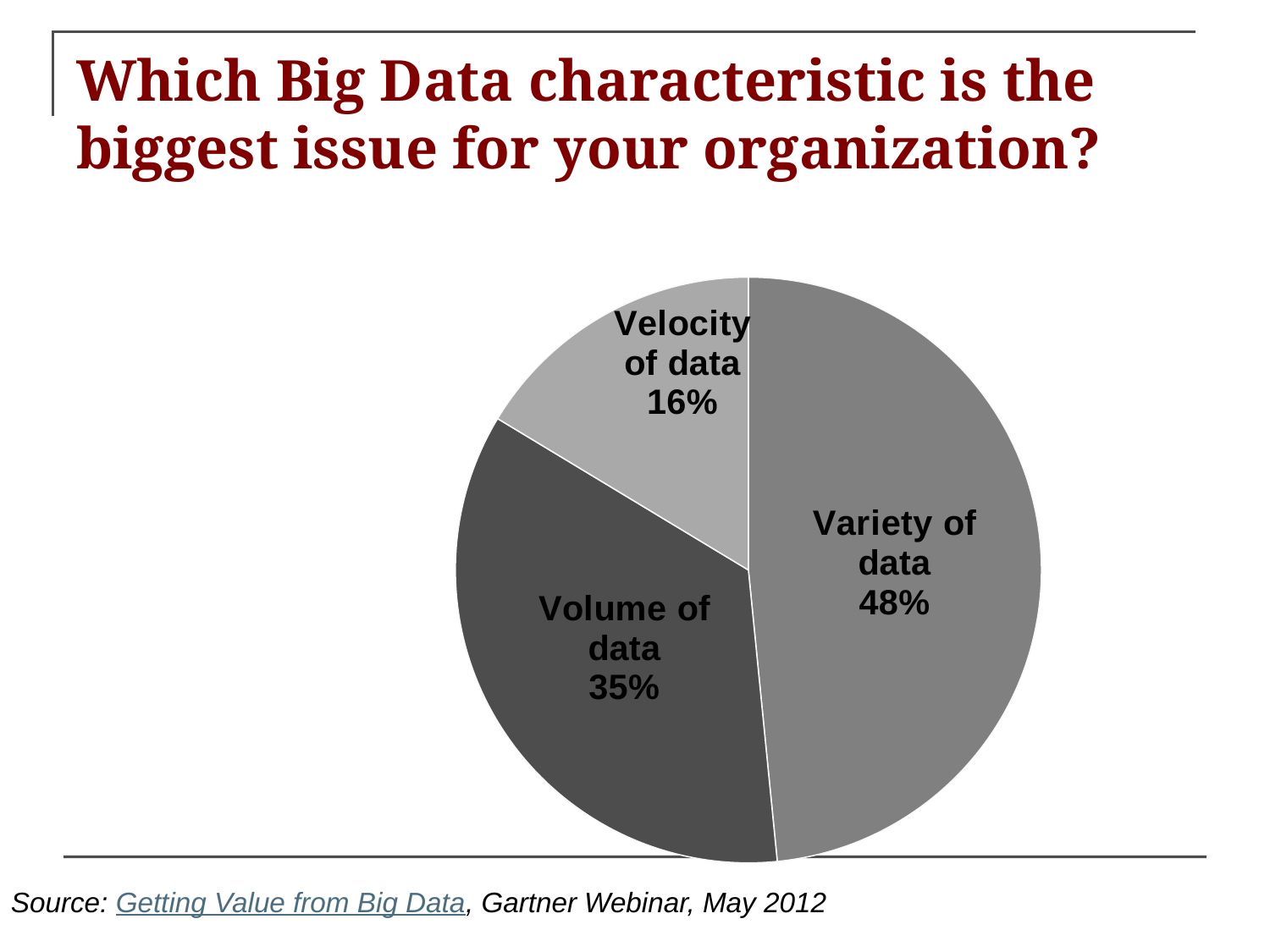
What share of the pie does the Variety of data slice represent? 48% What is the difference in percentage points between Volume of data and Velocity of data? 19 What is the difference in percentage points between Variety of data and Volume of data? 13 What percentage of respondents chose Variety of data as the biggest issue? 48% What kind of chart is shown on the slide? pie chart Which Big Data characteristic has the largest share of the pie? Variety of data What percentage is shown for Volume of data? 35% Which is larger, the share for Volume of data or the share for Velocity of data? Volume of data What percentage is shown for Velocity of data? 16% Which Big Data characteristic has the smallest share of the pie? Velocity of data How many slices does the pie chart have? 3 According to the slide, what is the source of the chart data? Getting Value from Big Data, Gartner Webinar, May 2012